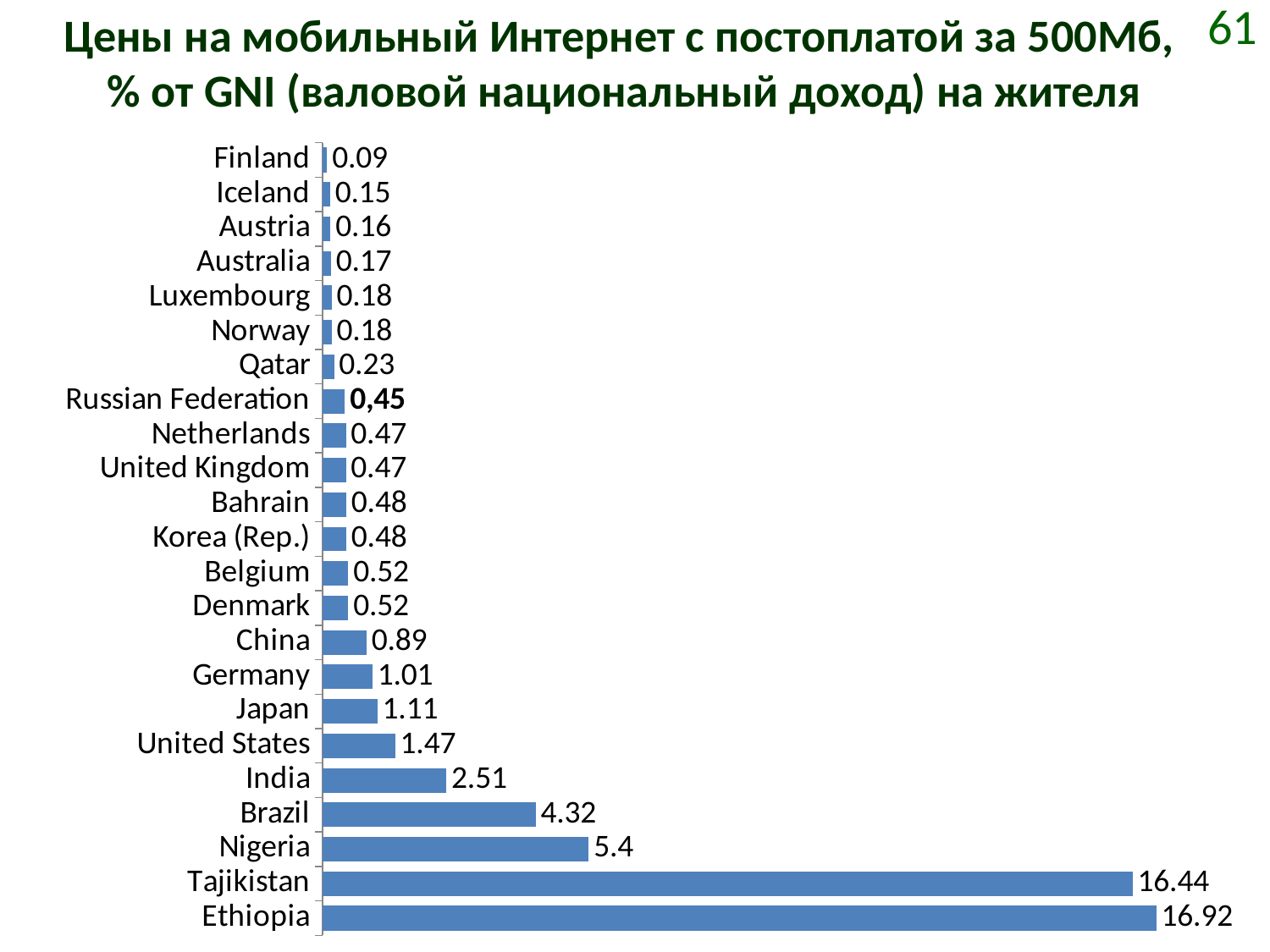
Which country has the highest value? Ethiopia What is the value for Ethiopia? 16.92 How many countries are shown in the chart? 23 What is the value for Nigeria? 5.4 What is the value for United States? 1.47 What kind of chart is shown on the slide? Bar chart What is the value for Russian Federation? 0,45 Which is larger, the value for Japan or the value for Germany? Japan What is the difference between the values for Brazil and India? 1.81 What is the value for China? 0.89 What is the difference between the values for Ethiopia and Tajikistan? 0.48 Which country has the lowest value? Finland